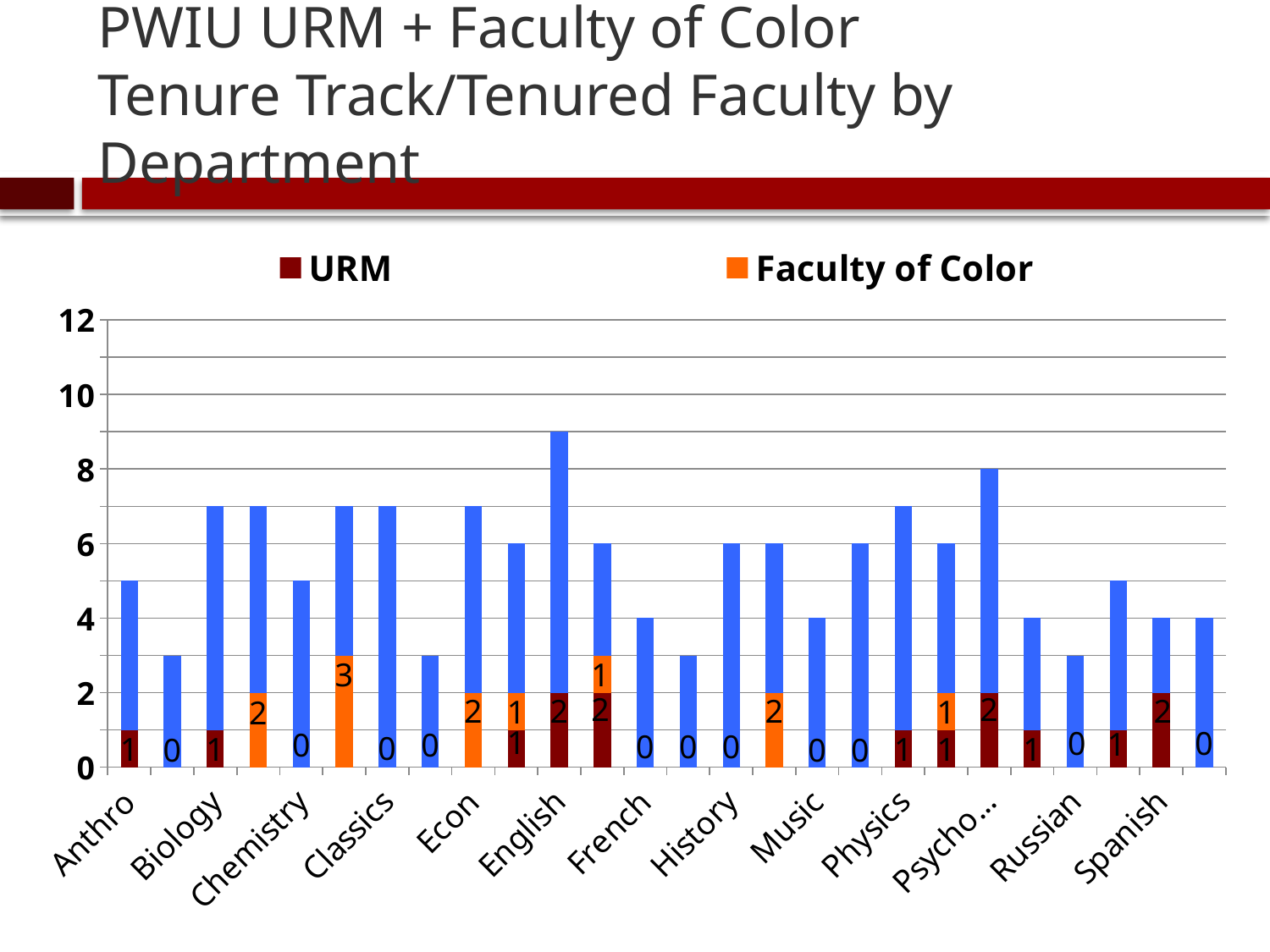
Which has the larger URM value, English or Anthro? English What colour represents URM in the legend? dark red What is the URM value for English? 2 What is the Faculty of Color value for Econ? 2 How many series does the legend list? 2 What is the difference between the URM value for English and the URM value for Anthro? 1 What is the highest value shown on the vertical axis? 12 What is the URM value for Physics? 1 What kind of chart is shown on the slide? bar chart What is the URM value for Anthro? 1 What is the URM value for Spanish? 2 What value is labeled on the Chemistry bar? 0